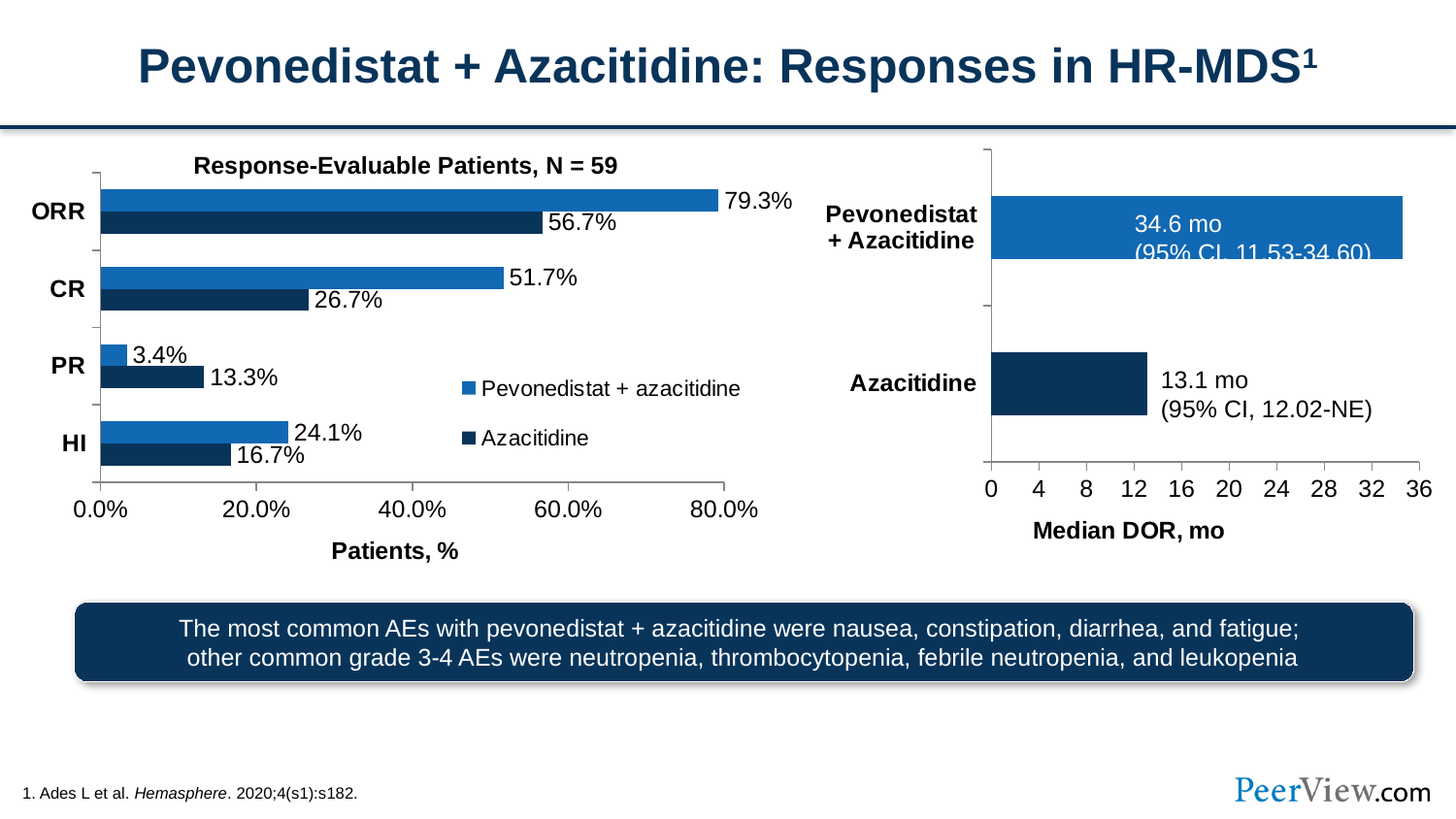
In the Response-Evaluable Patients chart on the left, what is the HI rate for azacitidine? 16.7% In the Median DOR chart on the right, what is the median DOR for azacitidine? 13.1 mo In the Response-Evaluable Patients chart on the left, which treatment has the higher PR rate? Azacitidine In the Response-Evaluable Patients chart on the left, how many response categories are shown? 4 In the Response-Evaluable Patients chart on the left, how many series does the legend list? 2 In the Response-Evaluable Patients chart on the left, what is the ORR for pevonedistat + azacitidine? 79.3% In the Median DOR chart on the right, which treatment has the longer median DOR? Pevonedistat + Azacitidine In the Median DOR chart on the right, what is the median DOR for pevonedistat + azacitidine? 34.6 mo In the Response-Evaluable Patients chart on the left, what is the PR rate for pevonedistat + azacitidine? 3.4% In the Response-Evaluable Patients chart on the left, what is the difference between the ORR for pevonedistat + azacitidine and the ORR for azacitidine? 22.6% In the Response-Evaluable Patients chart on the left, what is the CR rate for azacitidine? 26.7% What kind of chart is the Median DOR chart on the right? Bar chart